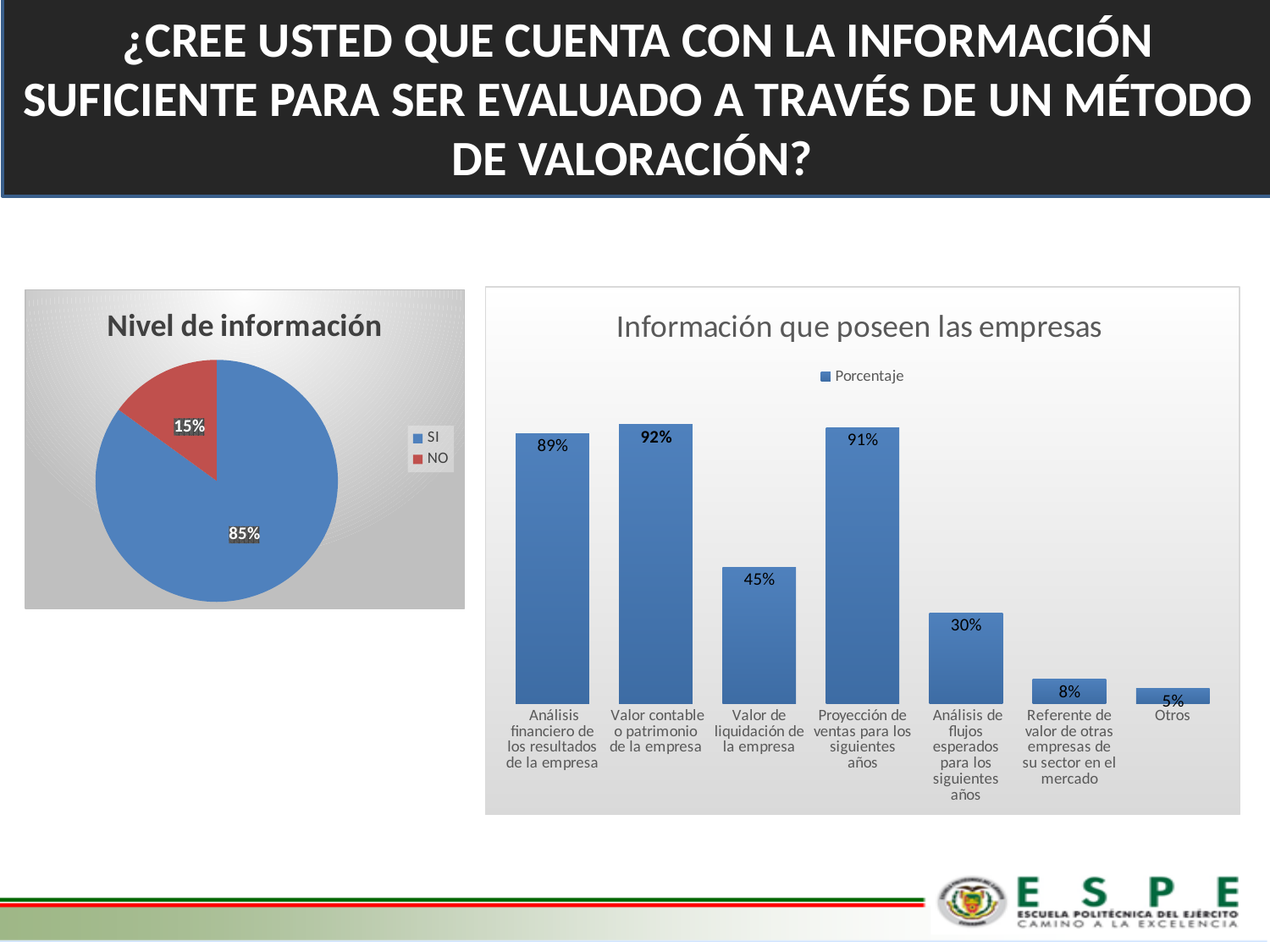
In the 'Nivel de información' pie chart, what percentage corresponds to NO? 15% In the 'Nivel de información' chart, what kind of chart is shown? pie chart In the 'Información que poseen las empresas' chart, which category has the lowest value? Otros In the 'Información que poseen las empresas' chart, what is the value for 'Análisis de flujos esperados para los siguientes años'? 30% In the 'Información que poseen las empresas' chart, what kind of chart is shown? bar chart In the 'Información que poseen las empresas' chart, how many categories are shown? 7 In the 'Nivel de información' pie chart, what percentage corresponds to SI? 85% In the 'Información que poseen las empresas' chart, which is larger: 'Proyección de ventas para los siguientes años' or 'Análisis de flujos esperados para los siguientes años'? Proyección de ventas para los siguientes años In the 'Nivel de información' pie chart, how many entries does the legend list? 2 In the 'Información que poseen las empresas' chart, what is the difference between 'Análisis financiero de los resultados de la empresa' and 'Valor de liquidación de la empresa'? 44% In the 'Información que poseen las empresas' chart, which category has the highest value? Valor contable o patrimonio de la empresa In the 'Información que poseen las empresas' chart, what is the value for 'Valor de liquidación de la empresa'? 45%